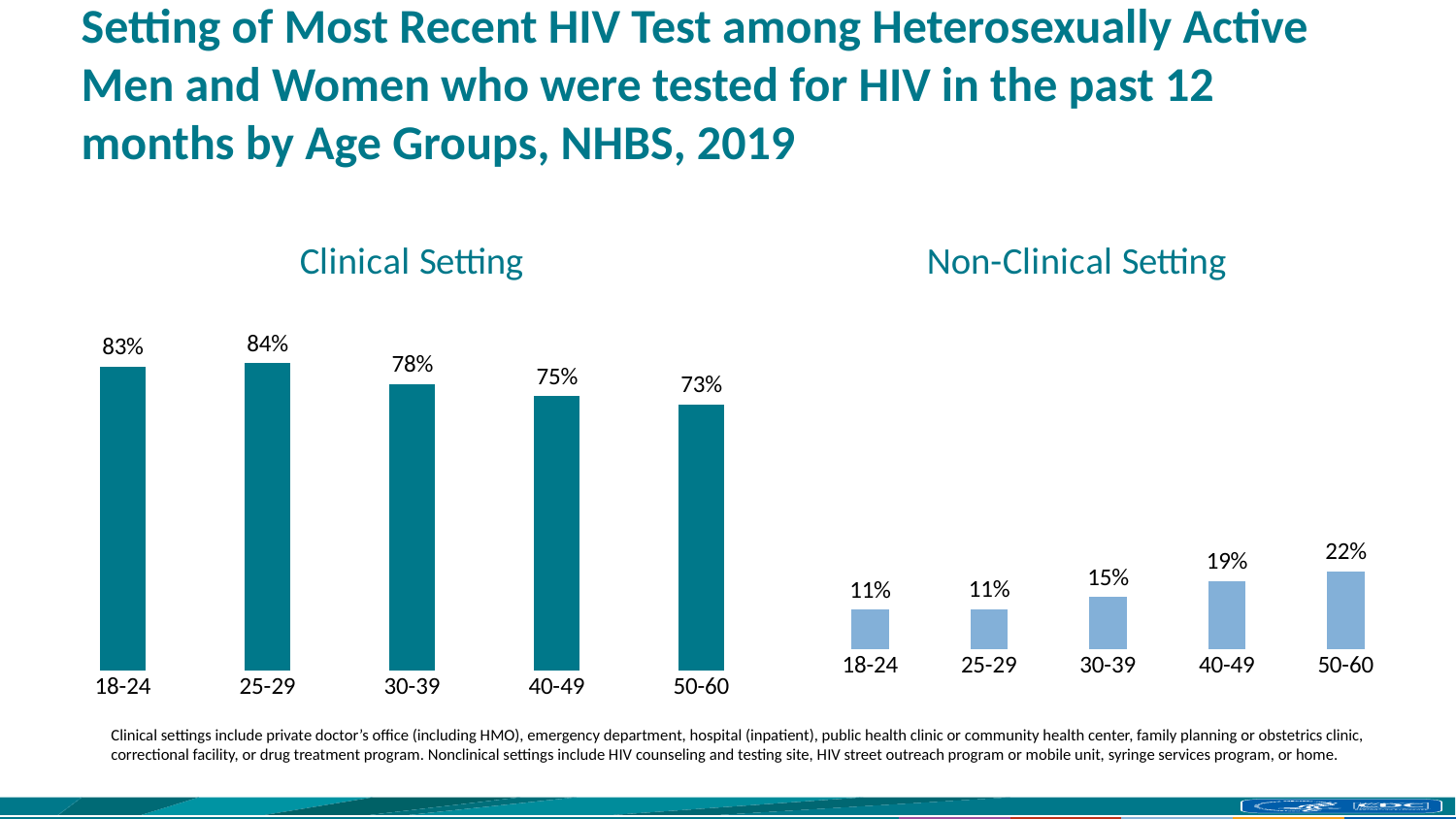
In the Non-Clinical Setting chart, do the values rise or fall as age group increases from 18-24 to 50-60? Rise What kind of chart is the Non-Clinical Setting chart? Bar chart In the Clinical Setting chart, what is the value for the 18-24 age group? 83% How many age groups are shown in the Clinical Setting chart? 5 In the Clinical Setting chart, what is the value for the 40-49 age group? 75% In the Non-Clinical Setting chart, what is the difference between the values for 50-60 and 18-24? 11% In the Non-Clinical Setting chart, which age group has the highest value? 50-60 In the Non-Clinical Setting chart, what is the value for the 50-60 age group? 22% In the Clinical Setting chart, what is the difference between the values for 25-29 and 50-60? 11% In the Non-Clinical Setting chart, which is larger, the value for 30-39 or the value for 40-49? 40-49 In the Clinical Setting chart, which age group has the lowest value? 50-60 In the Clinical Setting chart, which age group has the highest value? 25-29